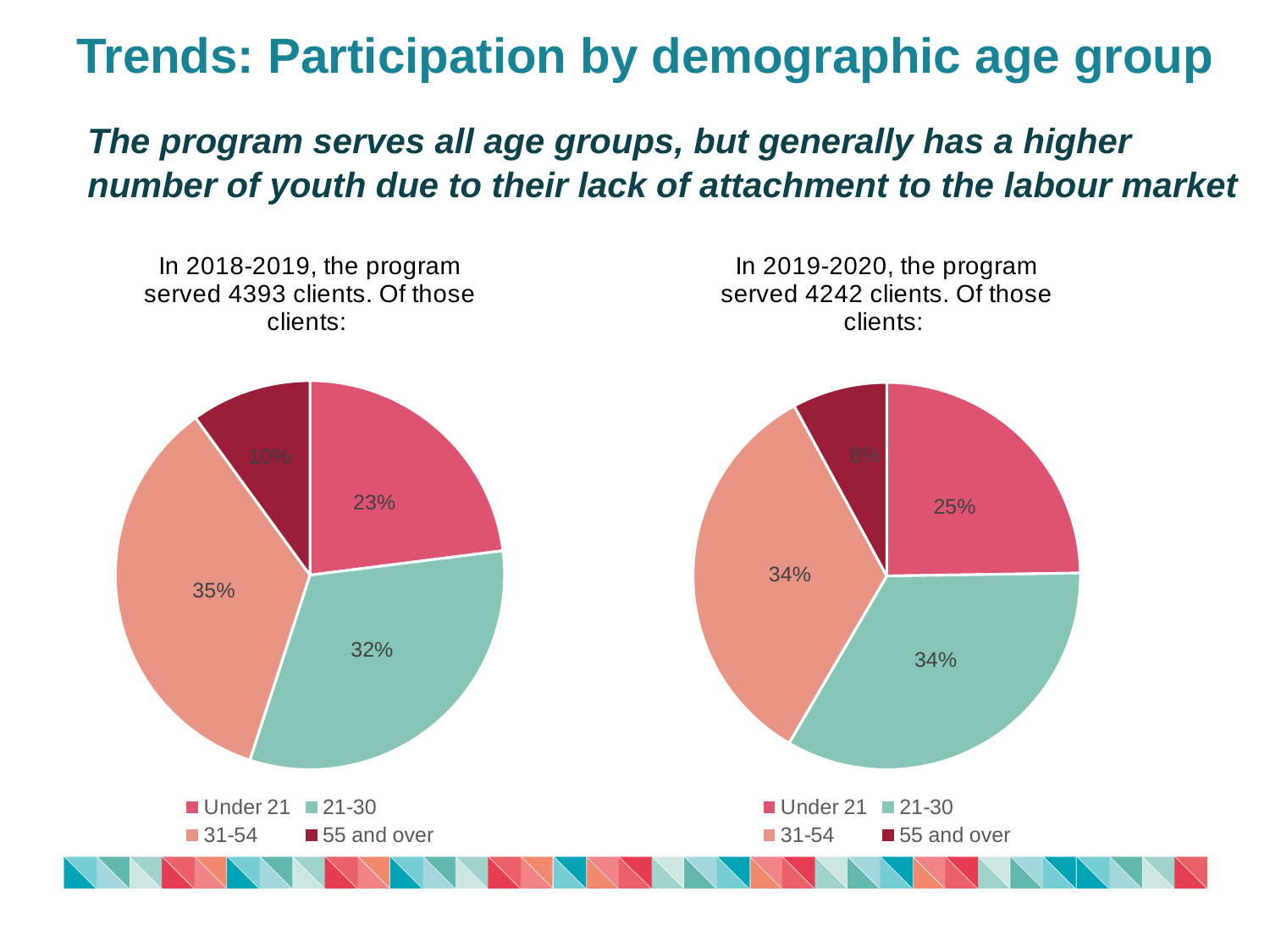
What type of chart is used to show participation by age group on this slide? Pie chart In the 2018-2019 pie chart, what share of clients were aged 31-54? 35% In the 2019-2020 pie chart, what share of clients were 55 and over? 8% In the 2018-2019 pie chart, what share of clients were 55 and over? 10% In the 2019-2020 pie chart, what share of clients were Under 21? 25% In the 2019-2020 pie chart, which age group has the smallest share? 55 and over In the 2018-2019 pie chart, which age group has the largest share? 31-54 According to the slide, how many clients did the program serve in 2019-2020? 4242 Comparing the two pie charts, is the Under 21 share larger in 2018-2019 or in 2019-2020? 2019-2020 How many age groups does the legend of the 2019-2020 pie chart list? 4 In the 2019-2020 pie chart, what share of clients were aged 21-30? 34% In the 2018-2019 pie chart, what is the difference in percentage points between the 21-30 share and the Under 21 share? 9 percentage points